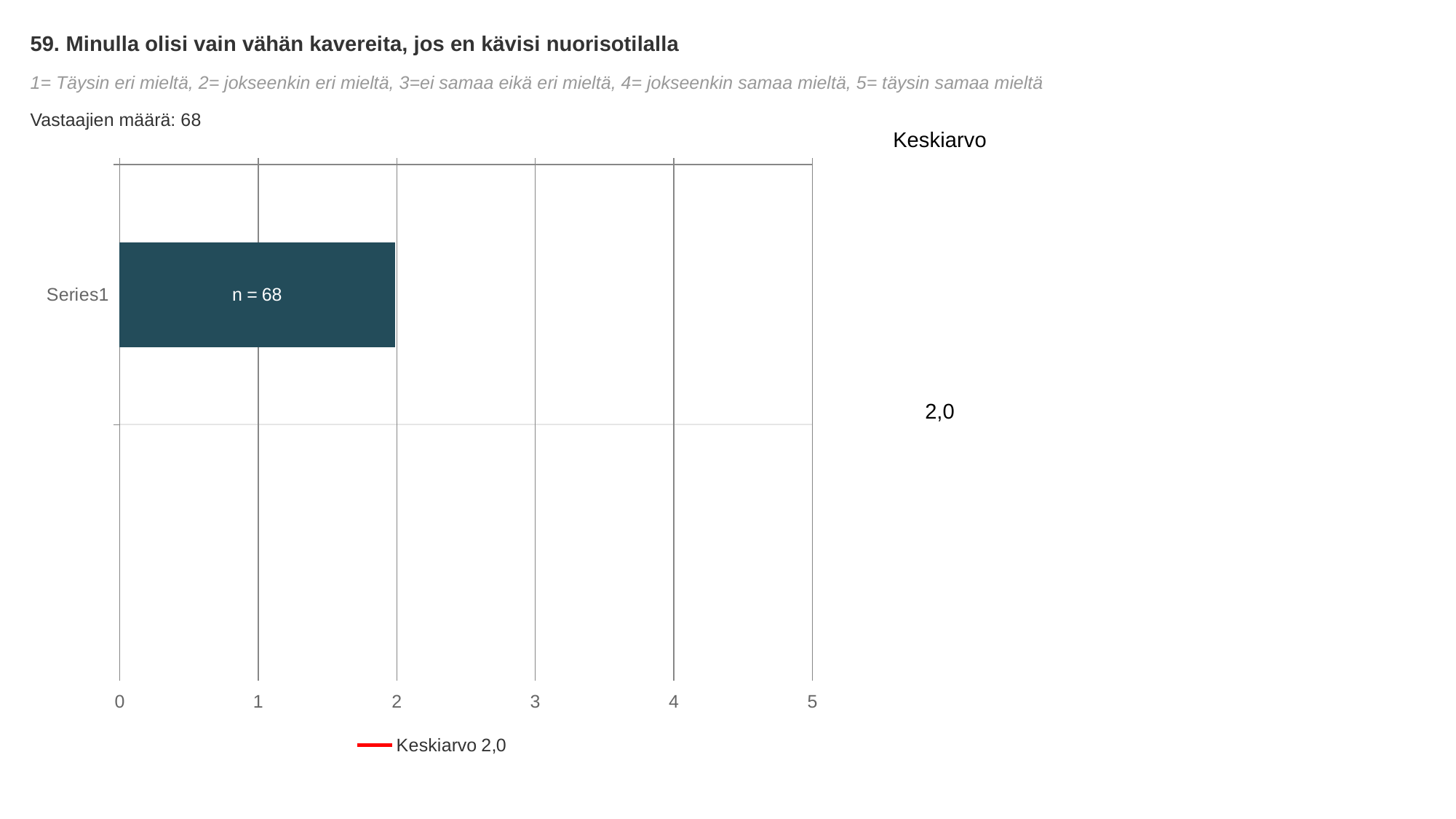
Is the value for Series1 greater or less than 3? less What kind of chart is shown on the slide? bar chart What is the maximum value shown on the x axis? 5 What data label is printed inside the bar for Series1? n = 68 Is the value for Series1 greater or less than 1? greater What does the legend entry below the chart say? Keskiarvo 2,0 What is the Keskiarvo (mean) value shown on the slide? 2,0 How many bars are plotted in the chart? 1 What is the value of the bar for Series1? 2,0 How many respondents (Vastaajien määrä) are reported on the slide? 68